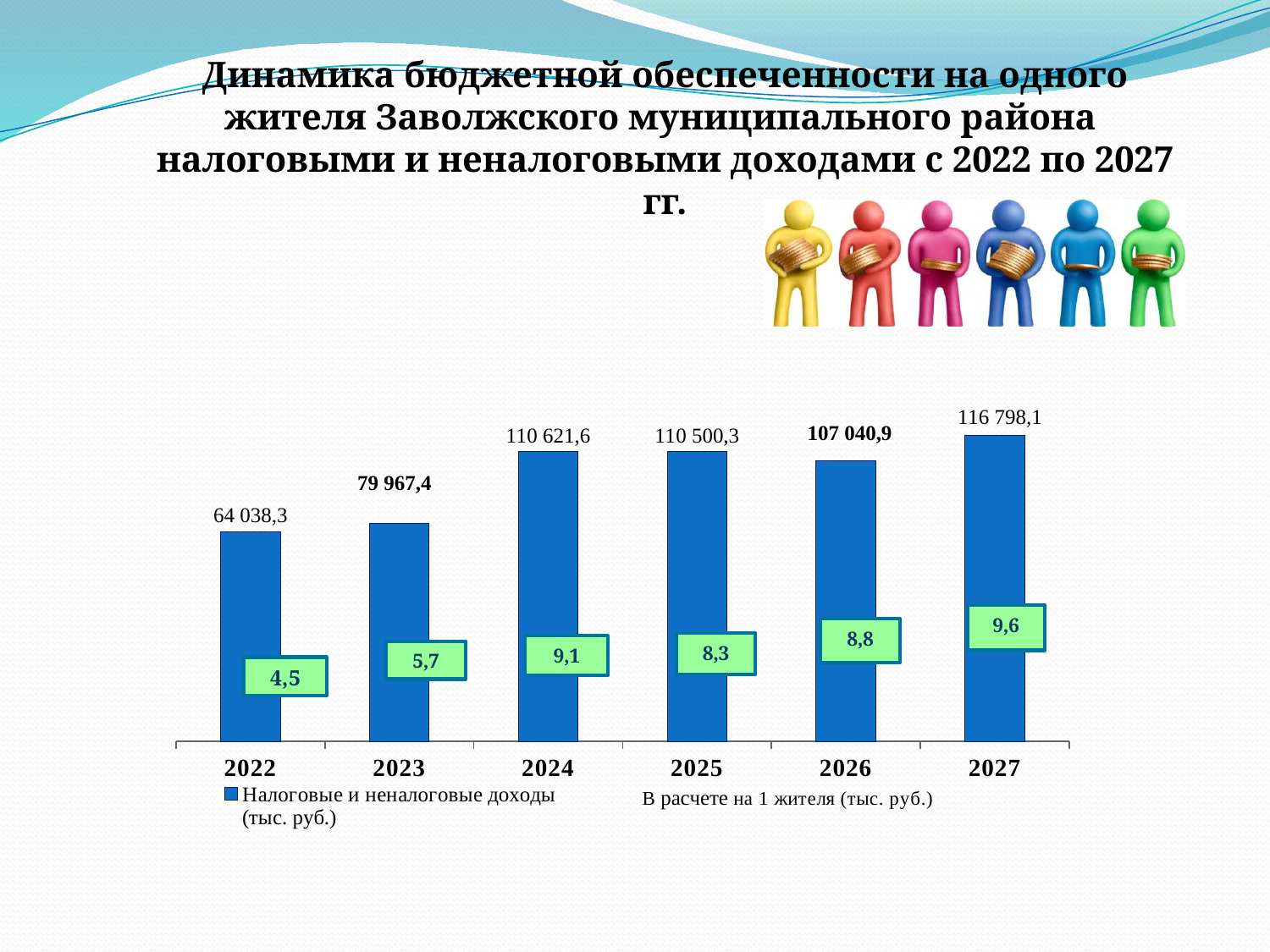
What is the per-resident value (В расчете на 1 жителя) shown for 2024? 9,1 Which year has the lowest per-resident value? 2022 What is the value of tax and non-tax revenues for 2027? 116 798,1 Does the per-resident value rise or fall from 2024 to 2025? Fall Which year has the highest tax and non-tax revenues? 2027 What is the per-resident value shown for 2026? 8,8 Which is larger, the tax and non-tax revenues for 2024 or for 2025? 2024 What is the value of tax and non-tax revenues (Налоговые и неналоговые доходы) for 2022? 64 038,3 What type of chart is shown on the slide? Bar chart What is the difference between the tax and non-tax revenues for 2023 and 2022? 15 929,1 What colour are the bars in the chart? Blue How many years are shown on the x axis? 6